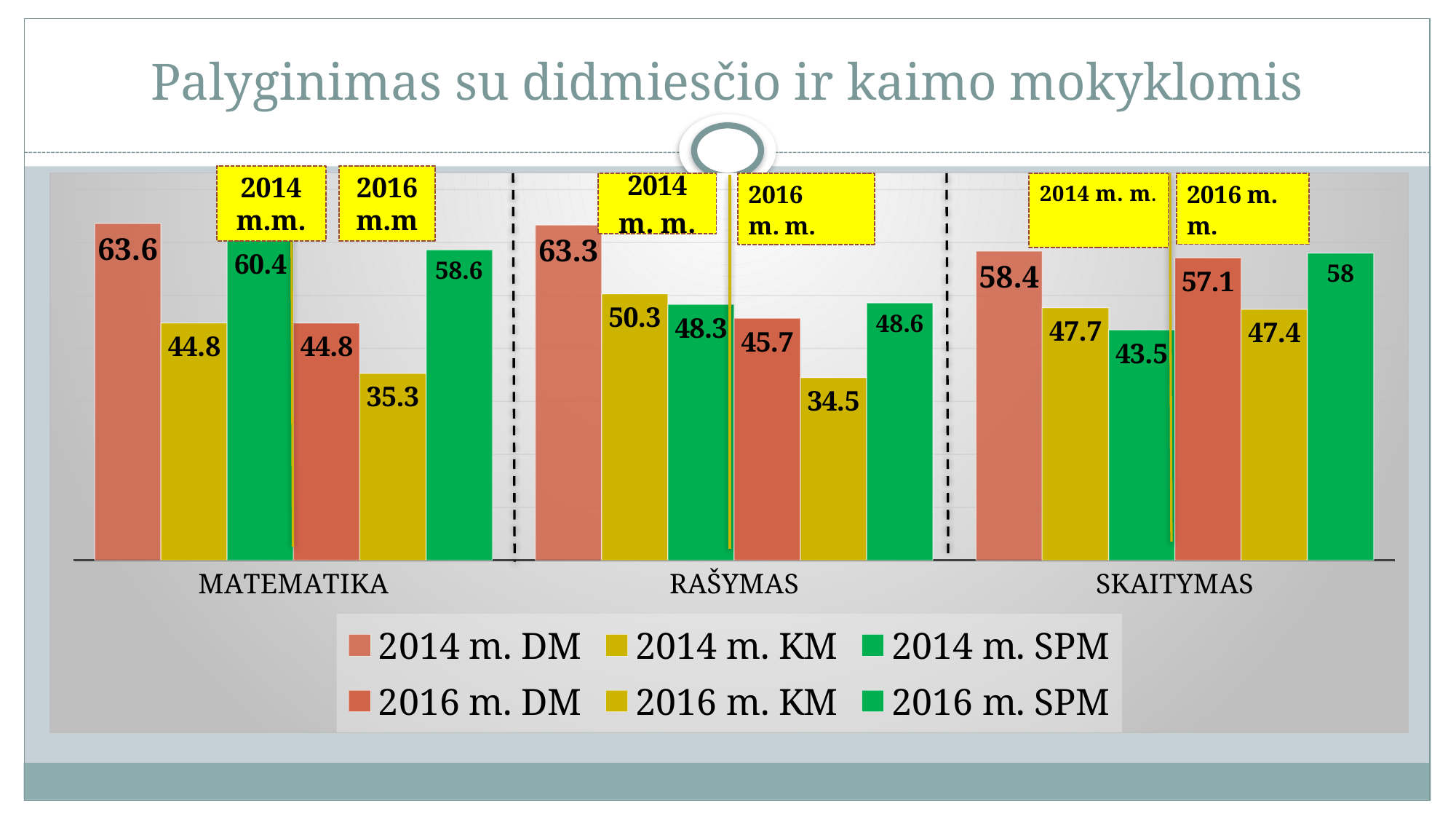
What is the value for 2016 m. KM in RAŠYMAS? 34.5 What kind of chart is shown on the slide? Bar chart What is the title of the slide? Palyginimas su didmiesčio ir kaimo mokyklomis Which series has the lowest value in SKAITYMAS? 2014 m. SPM How many series does the legend list? 6 Which series has the highest value in RAŠYMAS? 2014 m. DM What is the difference between the 2014 m. DM and 2016 m. DM values in MATEMATIKA? 18.8 Which is larger in SKAITYMAS: 2014 m. KM or 2016 m. KM? 2014 m. KM What is the value for 2014 m. DM in MATEMATIKA? 63.6 How many categories are shown on the x axis? 3 What is the value for 2014 m. SPM in MATEMATIKA? 60.4 What is the value for 2016 m. SPM in SKAITYMAS? 58